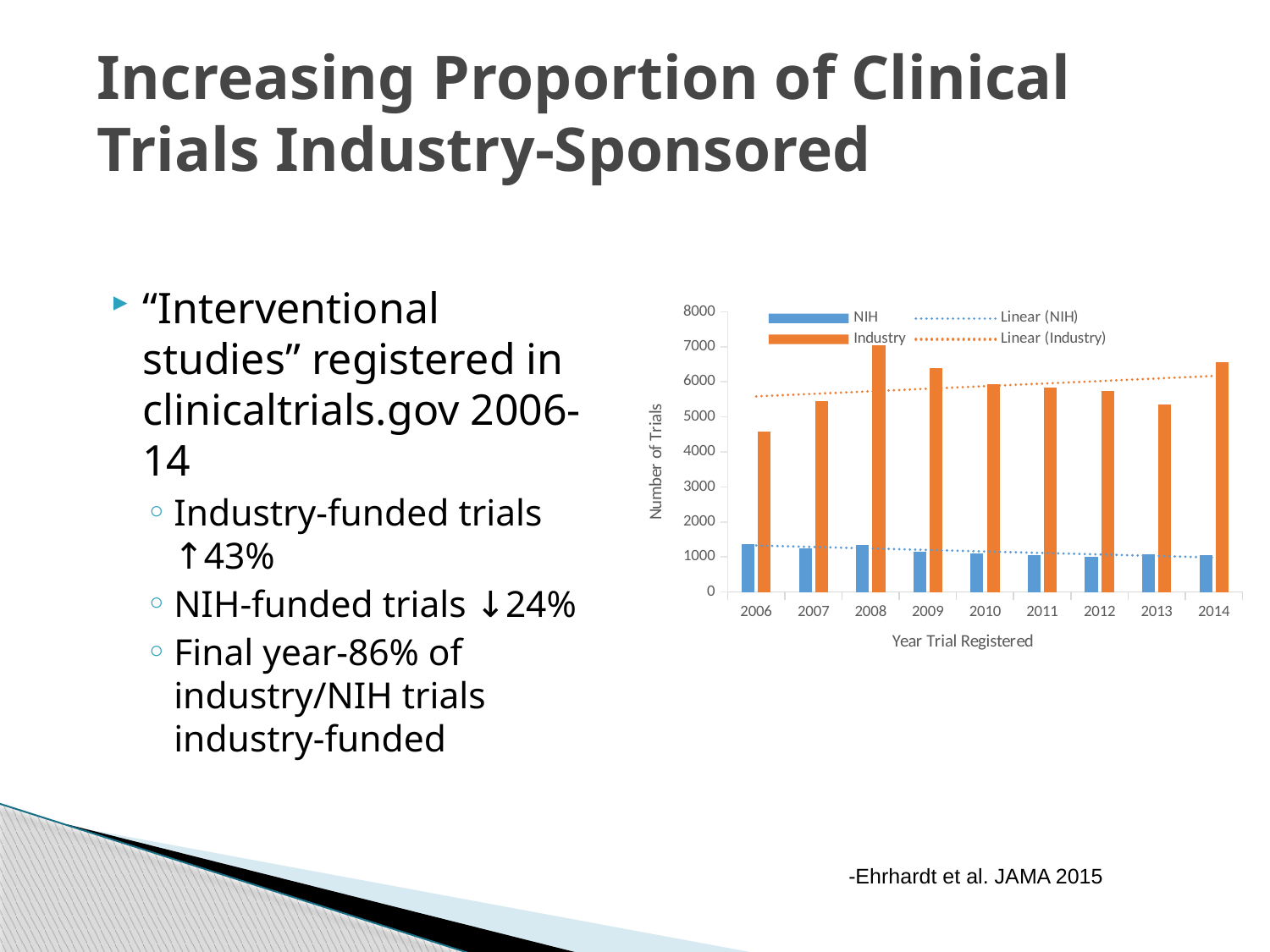
In which year is the Industry bar lowest? 2006 Which is larger in 2014, the NIH bar or the Industry bar? Industry In which year is the Industry bar highest? 2008 What kind of chart is shown on the slide? bar chart Is the Industry value for 2006 greater or less than 5000? less What is the label on the chart's x axis? Year Trial Registered Do the NIH values generally rise or fall from 2006 to 2014? fall How many entries does the chart's legend list? 4 Is the Industry value for 2008 greater or less than 6000? greater Which is larger for Industry, 2013 or 2014? 2014 Is the NIH value for 2012 greater or less than 2000? less How many years are shown along the x axis of the chart? 9